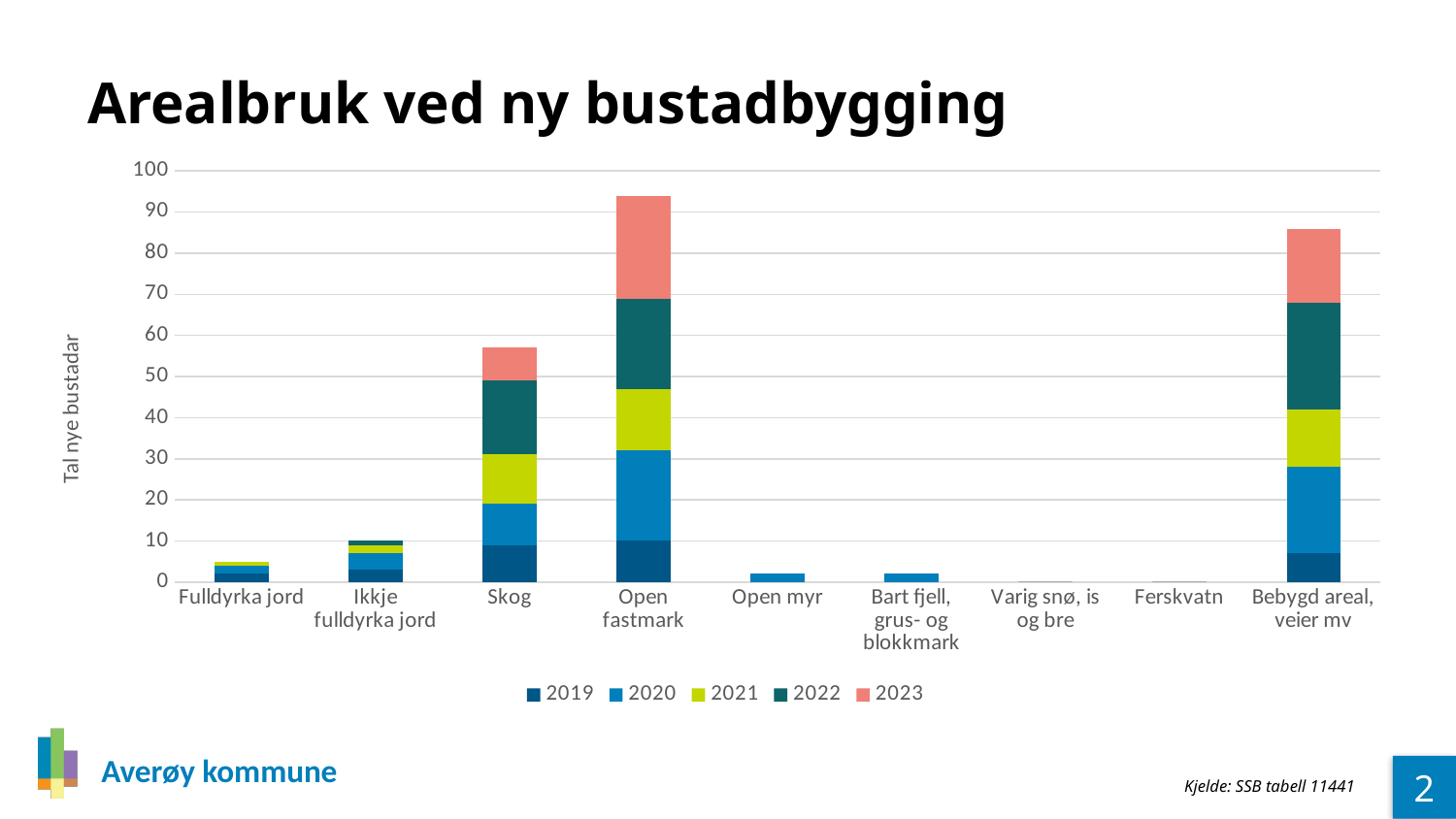
Is the total value for Bebygd areal, veier mv greater or less than 70? greater Is the total value for Fulldyrka jord greater or less than 10? less What kind of chart is shown on the slide? Stacked bar chart What is the label on the y axis of the chart? Tal nye bustadar Is the total value for Skog greater or less than 50? greater How many categories are shown on the x axis of the chart? 9 Which category has the highest total stacked bar? Open fastmark Which is larger, the total for Skog or the total for Ikkje fulldyrka jord? Skog How many series does the legend of the chart list? 5 What is the title of the chart on the slide? Arealbruk ved ny bustadbygging Which is larger, the total for Open fastmark or the total for Bebygd areal, veier mv? Open fastmark